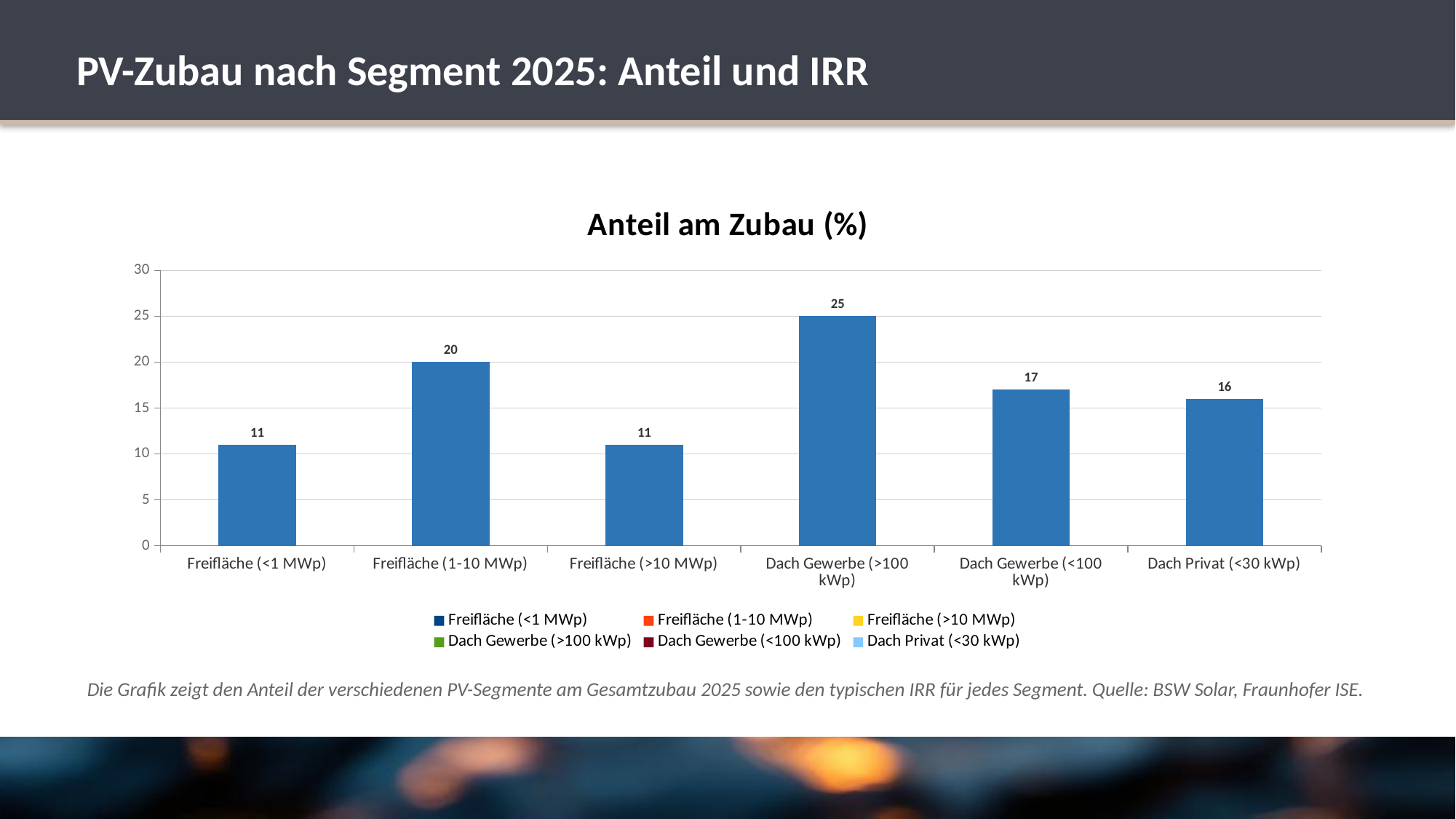
What is the value for Freifläche (1-10 MWp)? 20 Is the value for Freifläche (>10 MWp) greater or less than 15? less Which category has the highest value? Dach Gewerbe (>100 kWp) Which is larger, Dach Gewerbe (<100 kWp) or Dach Privat (<30 kWp)? Dach Gewerbe (<100 kWp) How many categories are shown on the x axis? 6 What is the value for Dach Privat (<30 kWp)? 16 What is the difference between Dach Gewerbe (>100 kWp) and Freifläche (<1 MWp)? 14 What is the difference between Freifläche (1-10 MWp) and Dach Gewerbe (<100 kWp)? 3 What is the title of the chart? Anteil am Zubau (%) What is the value for Dach Gewerbe (>100 kWp)? 25 How many entries does the legend list? 6 What kind of chart is shown? bar chart